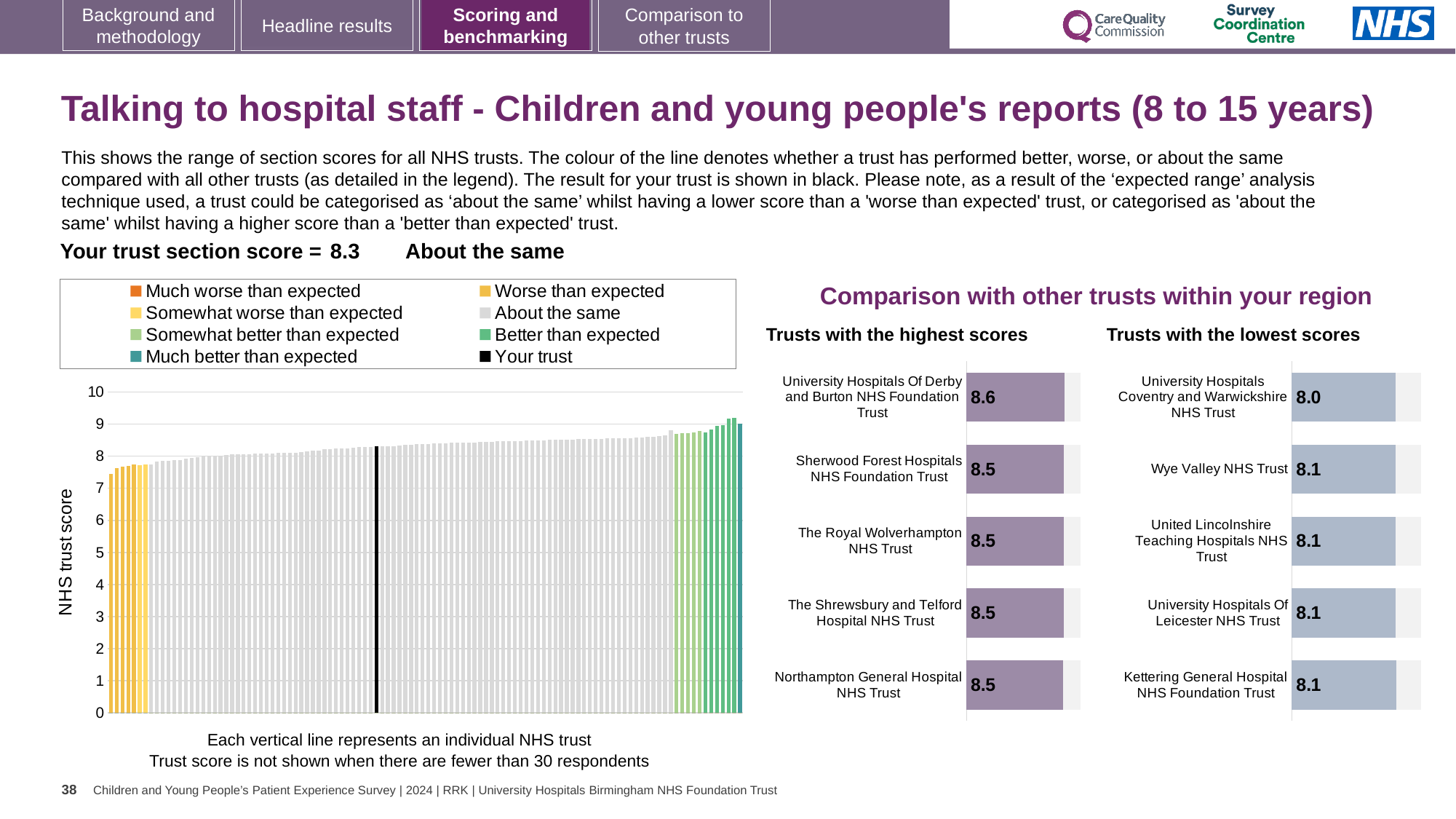
What kind of chart is the large chart on the left of the slide? bar chart In the 'Trusts with the highest scores' chart, what is the score for Northampton General Hospital NHS Trust? 8.5 In the 'Trusts with the lowest scores' chart, what is the score for Wye Valley NHS Trust? 8.1 In the large chart on the left, is the value for the black bar (your trust) greater or less than 8? greater How many trusts are shown in the 'Trusts with the highest scores' chart? 5 Which has the higher score: Sherwood Forest Hospitals NHS Foundation Trust in the highest scores chart or United Lincolnshire Teaching Hospitals NHS Trust in the lowest scores chart? Sherwood Forest Hospitals NHS Foundation Trust In the 'Trusts with the lowest scores' chart, which trust has the lowest score? University Hospitals Coventry and Warwickshire NHS Trust In the 'Trusts with the highest scores' chart, what is the score for University Hospitals Of Derby and Burton NHS Foundation Trust? 8.6 What is the difference between the score for University Hospitals Of Derby and Burton NHS Foundation Trust in the highest scores chart and the score for Kettering General Hospital NHS Foundation Trust in the lowest scores chart? 0.5 In the 'Trusts with the highest scores' chart, which trust has the highest score? University Hospitals Of Derby and Burton NHS Foundation Trust In the large chart on the left, do the trust scores rise or fall from left to right? rise In the 'Trusts with the lowest scores' chart, what is the score for University Hospitals Coventry and Warwickshire NHS Trust? 8.0